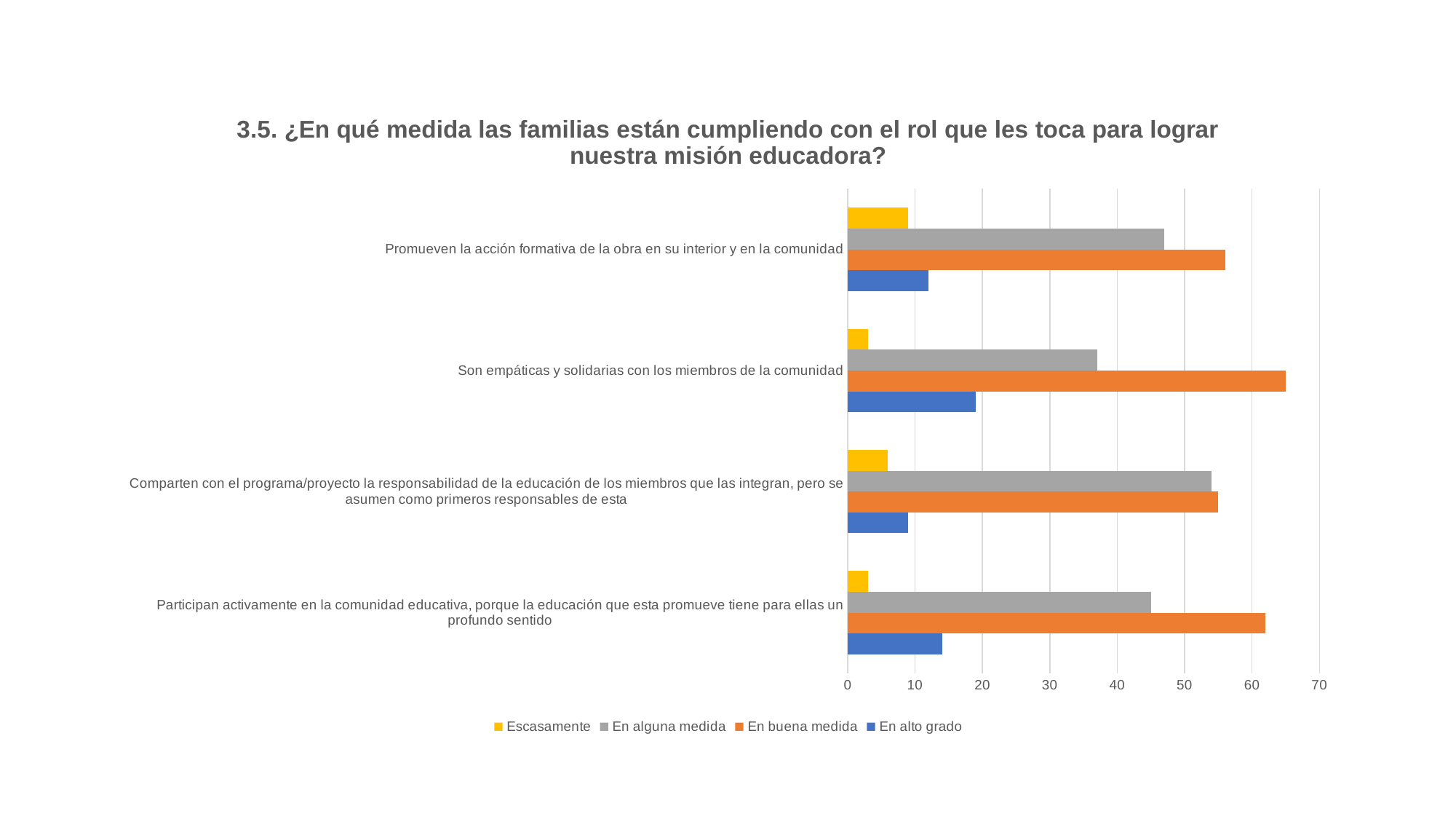
Is the 'En buena medida' value for 'Son empáticas y solidarias con los miembros de la comunidad' greater or less than 60? greater What kind of chart is shown on the slide? bar chart For 'Promueven la acción formativa de la obra en su interior y en la comunidad', which is larger: 'En alguna medida' or 'En buena medida'? En buena medida How many categories (statements) are plotted on the chart? 4 Which category has the highest value for 'En alguna medida'? Comparten con el programa/proyecto la responsabilidad de la educación de los miembros que las integran, pero se asumen como primeros responsables de esta Which category has the lowest value for 'En alguna medida'? Son empáticas y solidarias con los miembros de la comunidad For 'Son empáticas y solidarias con los miembros de la comunidad', which is larger: 'Escasamente' or 'En alto grado'? En alto grado Is the 'En alguna medida' value for 'Promueven la acción formativa de la obra en su interior y en la comunidad' greater or less than 50? less What is the title of the chart? 3.5. ¿En qué medida las familias están cumpliendo con el rol que les toca para lograr nuestra misión educadora? How many series does the legend list? 4 What colour represents the 'En buena medida' series in the legend? orange Is the 'En alto grado' value for 'Son empáticas y solidarias con los miembros de la comunidad' greater or less than 10? greater